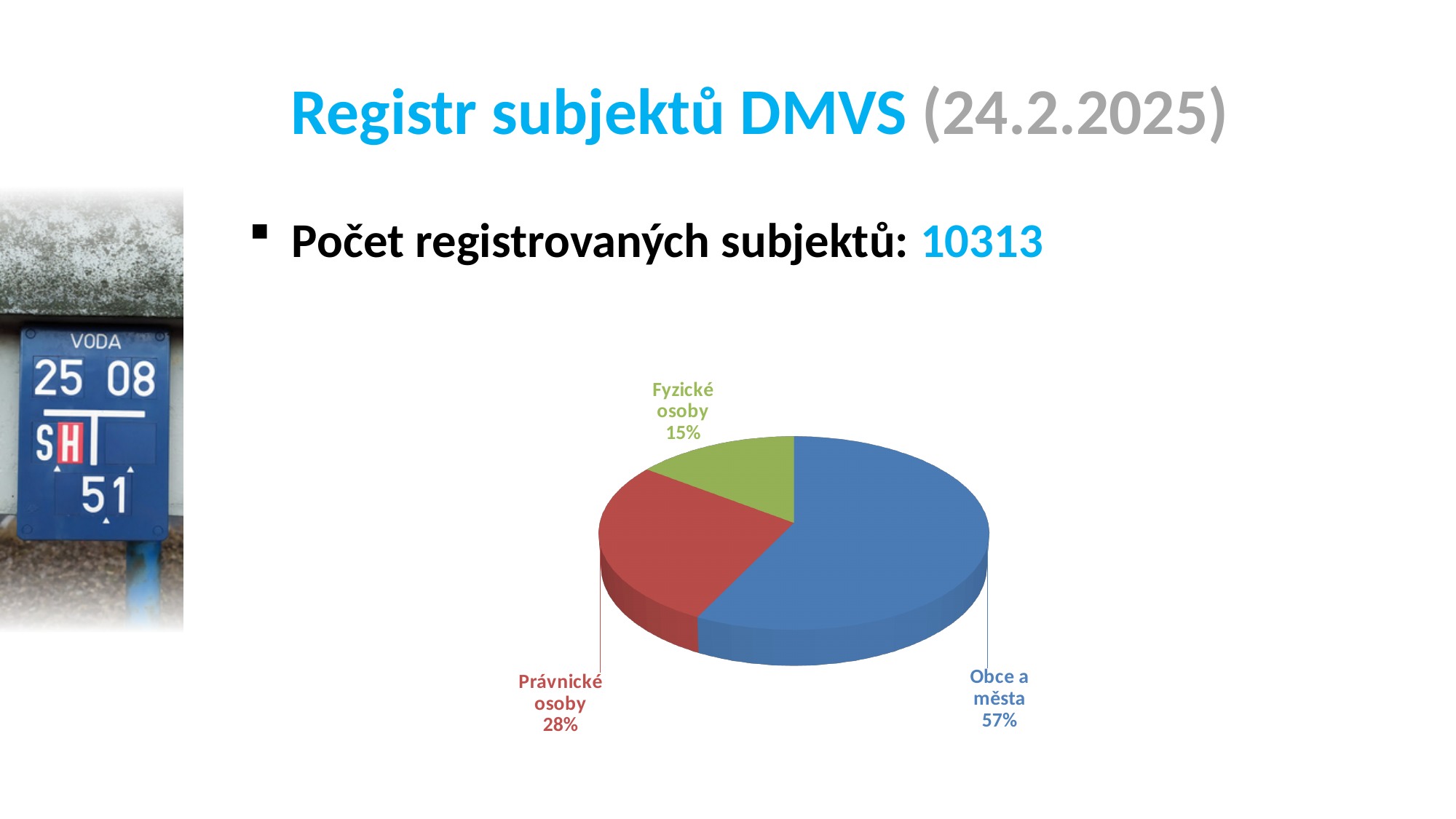
What colour is the slice for Obce a města? blue What share of the pie does Obce a města have? 57% Which is larger, the share for Právnické osoby or the share for Fyzické osoby? Právnické osoby What share of the pie does Fyzické osoby have? 15% What is the difference in percentage points between Obce a města and Právnické osoby? 29 What is the difference in percentage points between Právnické osoby and Fyzické osoby? 13 What colour is the slice for Fyzické osoby? green What kind of chart is shown on the slide? pie chart How many slices does the pie chart have? 3 Which category has the smallest slice of the pie? Fyzické osoby What share of the pie does Právnické osoby have? 28% Which category has the largest slice of the pie? Obce a města